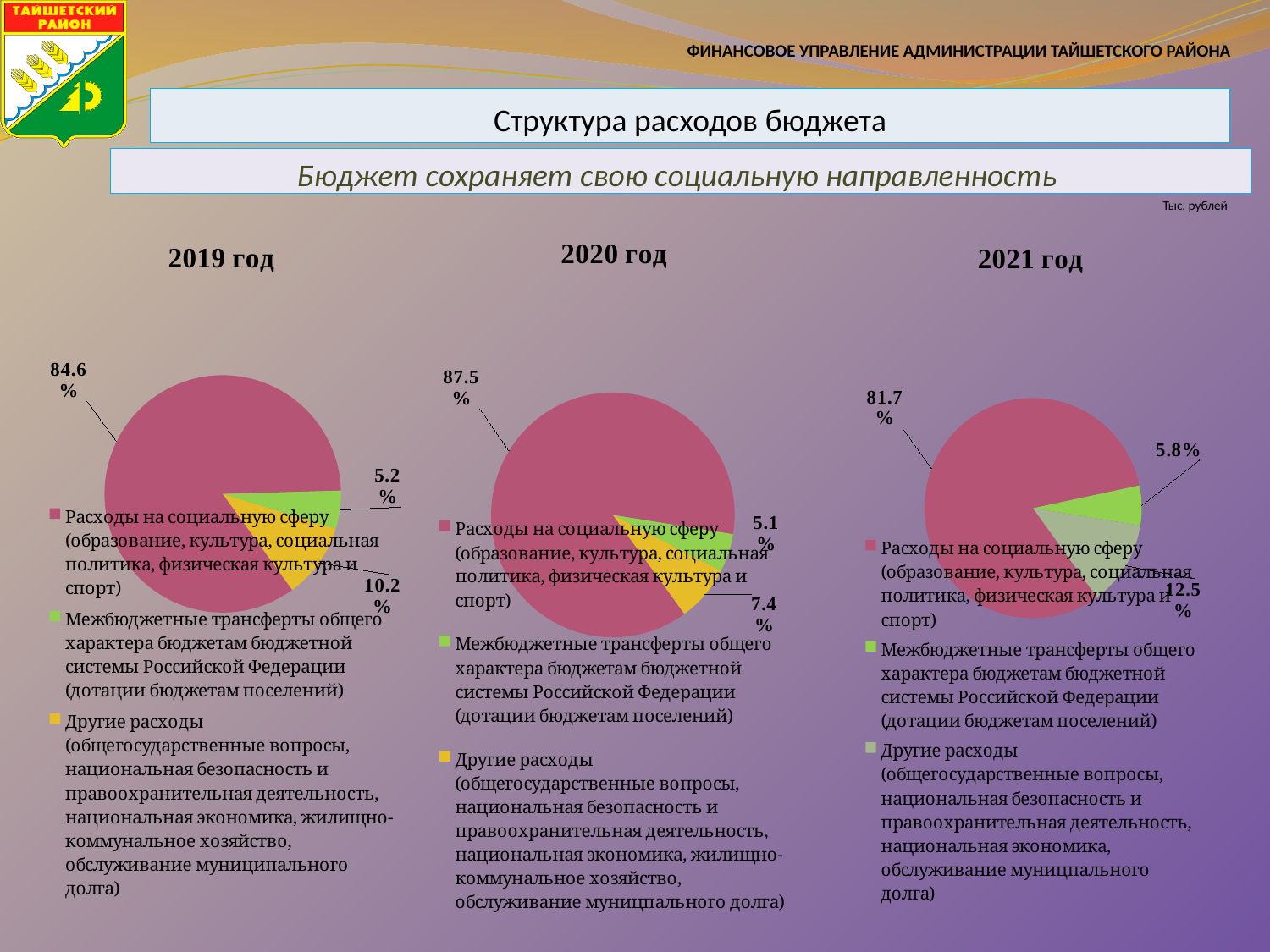
In the 2019 год pie chart, what share is shown for Расходы на социальную сферу? 84.6% In the 2021 год pie chart, what is the combined share of Межбюджетные трансферты and Другие расходы? 18.3% What type of chart is used for the 2019 год data? pie chart In the 2020 год pie chart, what share is shown for Другие расходы? 7.4% In the 2019 год pie chart, which category has the smallest share? Межбюджетные трансферты общего характера In the 2021 год pie chart, what share is shown for Межбюджетные трансферты общего характера? 5.8% Which is larger: the share for Другие расходы in the 2021 год chart or in the 2019 год chart? 2021 год What colour represents Расходы на социальную сферу in the pie charts? pink How many slices does the 2020 год pie chart have? 3 In the 2020 год pie chart, what is the difference between the share for Расходы на социальную сферу and the share for Другие расходы? 80.1% In the 2021 год pie chart, which category has the largest share? Расходы на социальную сферу How many pie charts are shown on the slide? 3